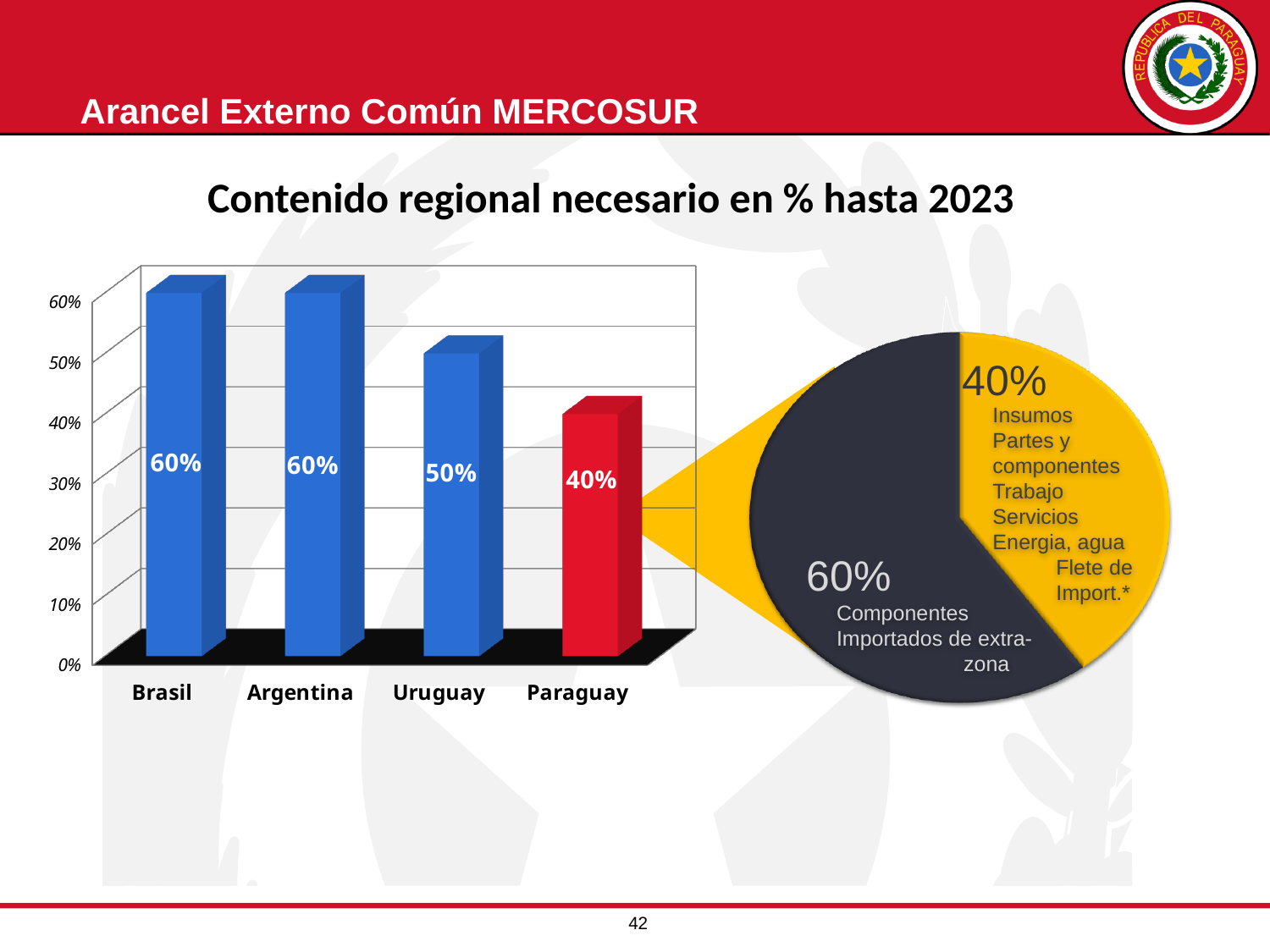
In the bar chart, which country has the lowest value? Paraguay In the pie chart, what share is labelled 'Componentes Importados de extra-zona'? 60% In the bar chart, what is the value for Brasil? 60% In the bar chart, what is the difference between the values for Brasil and Paraguay? 20% In the bar chart, what is the value for Uruguay? 50% What is the title of the bar chart? Contenido regional necesario en % hasta 2023 In the bar chart, do the values rise or fall from Brasil to Paraguay along the x axis? Fall In the bar chart, what is the value for Paraguay? 40% In the pie chart, how many slices are there? 2 In the bar chart, how many countries are shown? 4 In the bar chart, which is larger, the value for Uruguay or the value for Paraguay? Uruguay What kind of chart is the one on the left of the slide? Bar chart